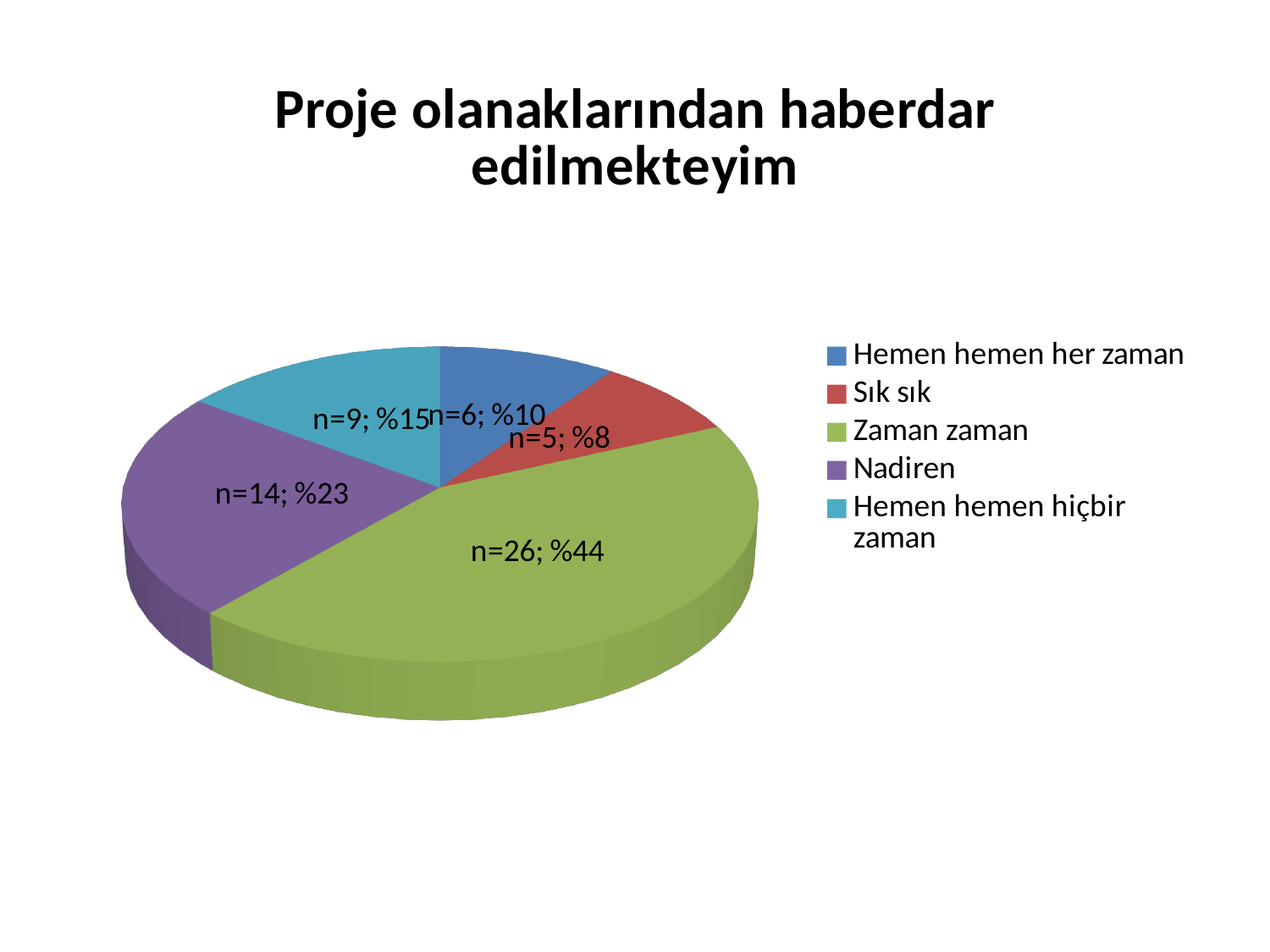
What kind of chart is shown on the slide? pie chart What is the n value for the 'Sık sık' slice? n=5 What is the n value for the 'Nadiren' slice? n=14 What percentage share does the 'Hemen hemen hiçbir zaman' slice have? %15 Which category has the largest slice? Zaman zaman What percentage share does the 'Zaman zaman' slice have? %44 What is the title of the chart? Proje olanaklarından haberdar edilmekteyim How many categories does the legend list? 5 Which is larger, the 'Hemen hemen her zaman' slice or the 'Hemen hemen hiçbir zaman' slice? Hemen hemen hiçbir zaman Which category has the smallest slice? Sık sık What is the difference in n between 'Zaman zaman' and 'Nadiren'? 12 What is the n value for the 'Zaman zaman' slice? n=26